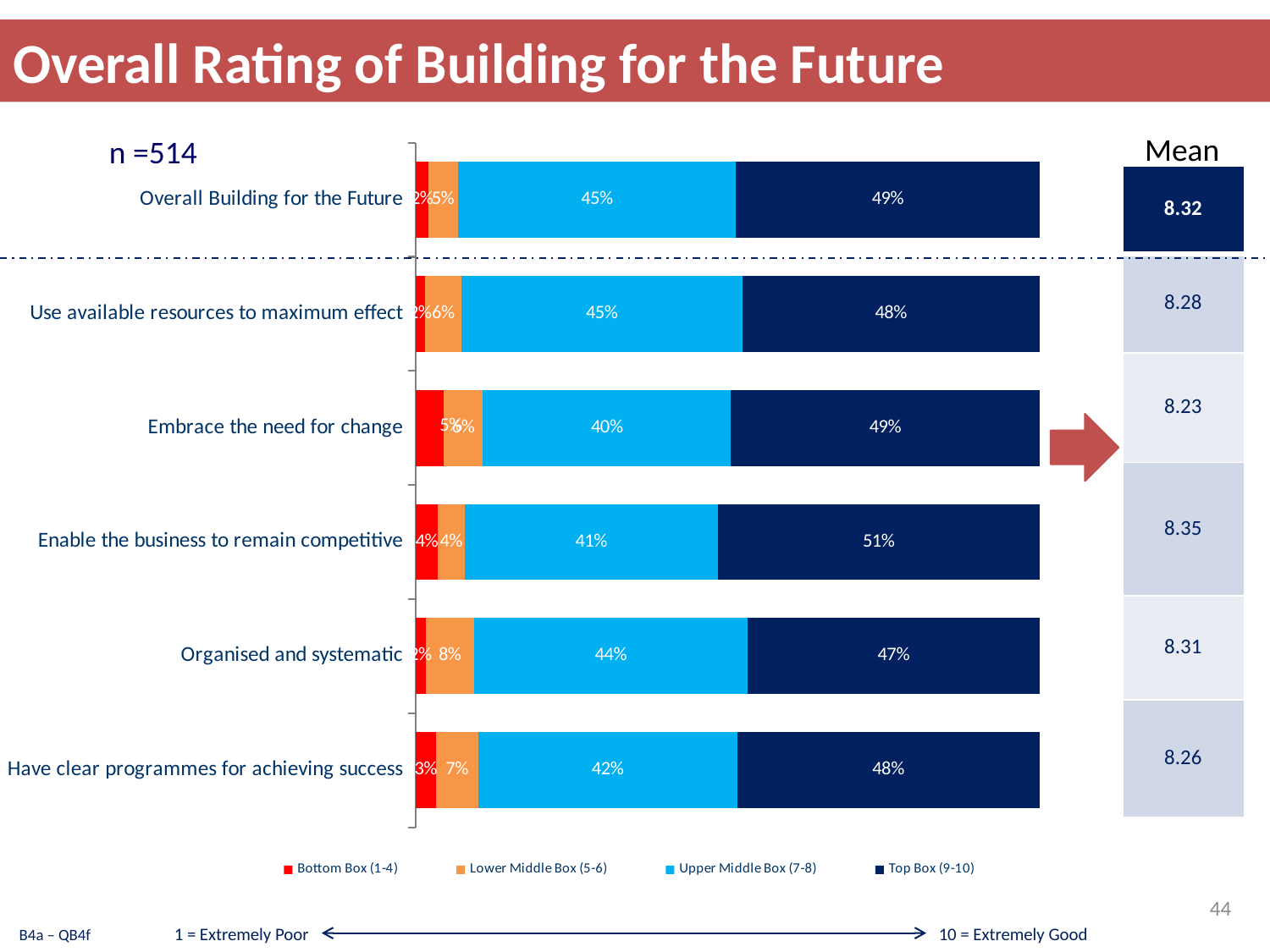
What is the Upper Middle Box (7-8) value for 'Embrace the need for change'? 40% How many series does the legend list? 4 Which category has the highest Top Box (9-10) value? Enable the business to remain competitive What is the Lower Middle Box (5-6) value for 'Organised and systematic'? 8% Which category has the lowest Top Box (9-10) value? Organised and systematic How many categories are shown in the chart? 6 What kind of chart is shown on the slide? Stacked bar chart What is the Top Box (9-10) value for 'Have clear programmes for achieving success'? 48% Which category has the lowest Upper Middle Box (7-8) value? Embrace the need for change Which has the larger Upper Middle Box (7-8) value: 'Overall Building for the Future' or 'Embrace the need for change'? Overall Building for the Future What is the Top Box (9-10) value for 'Enable the business to remain competitive'? 51% What is the difference in Top Box (9-10) value between 'Enable the business to remain competitive' and 'Organised and systematic'? 4 percentage points